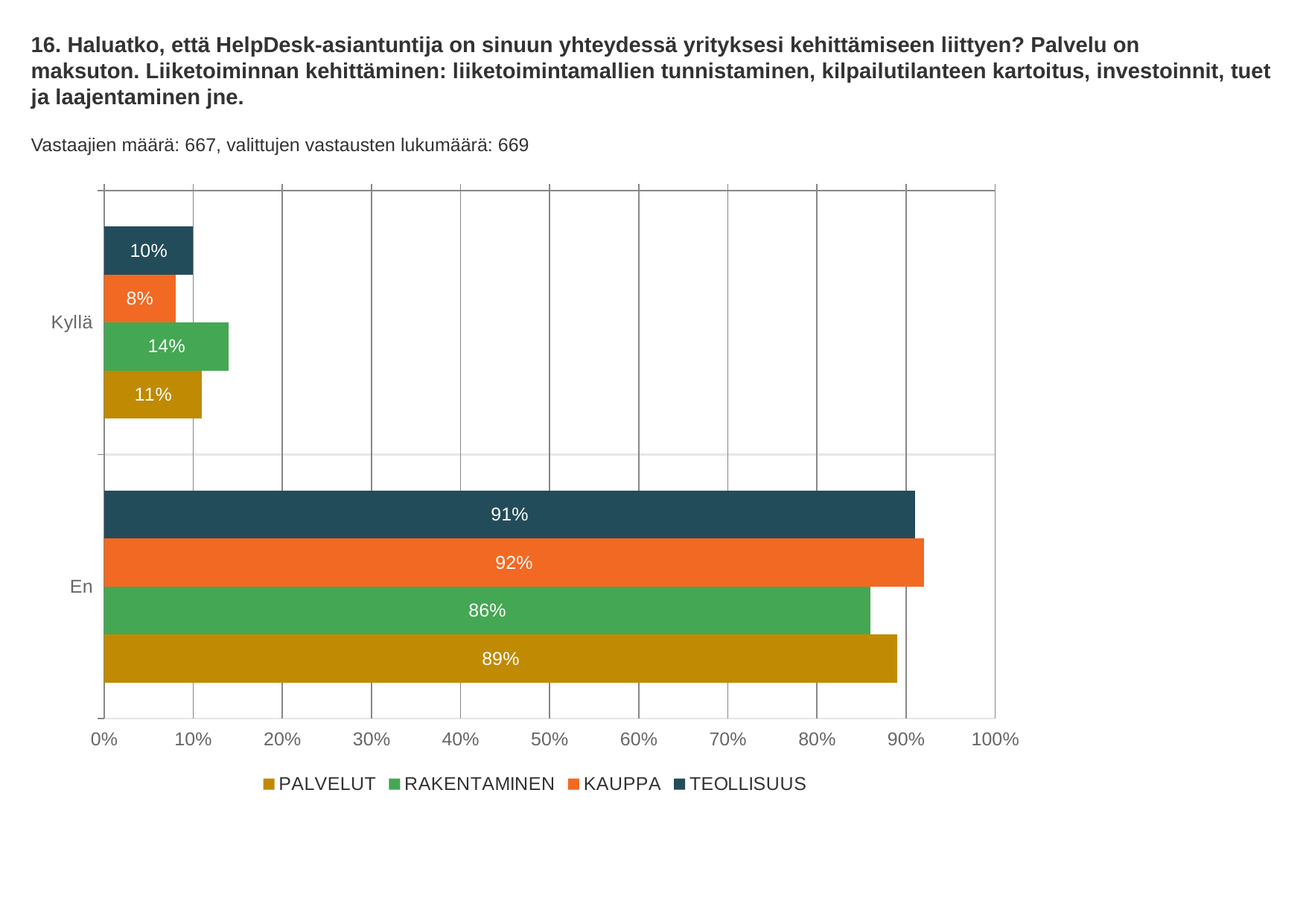
Which series has the lowest value in the En category? RAKENTAMINEN What is the value for TEOLLISUUS in the Kyllä category? 10% What colour represents the KAUPPA series? Orange How many categories are shown on the vertical axis? 2 What is the value for RAKENTAMINEN in the En category? 86% Which series has the highest value in the Kyllä category? RAKENTAMINEN What is the difference between the KAUPPA and RAKENTAMINEN values in the En category? 6% Which is larger in the Kyllä category: PALVELUT or TEOLLISUUS? PALVELUT What is the value for PALVELUT in the En category? 89% What kind of chart is shown on the slide? Bar chart How many series does the legend list? 4 What is the value for KAUPPA in the Kyllä category? 8%